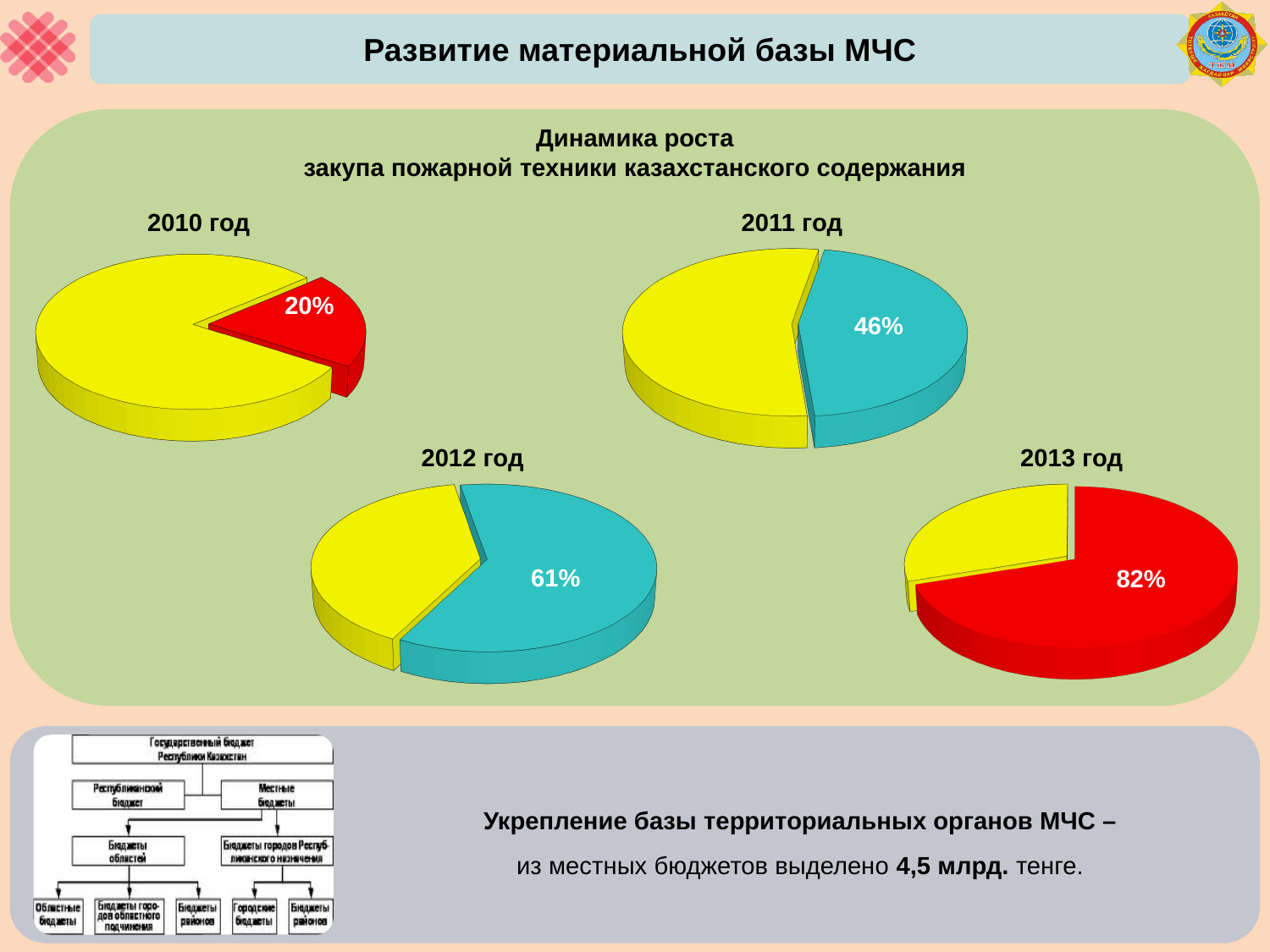
On the 2012 год pie chart, what percentage is shown on the labelled slice? 61% What is the difference between the labelled percentage on the 2013 год chart and the labelled percentage on the 2010 год chart? 62% What colour is the labelled 82% slice on the 2013 год pie chart? Red Which is larger: the labelled percentage on the 2012 год chart or on the 2011 год chart? 2012 год On the 2011 год pie chart, what percentage is shown on the labelled slice? 46% Which year's pie chart shows the lowest labelled percentage? 2010 год Which year's pie chart shows the highest labelled percentage? 2013 год How many pie charts are shown on the slide? 4 Do the labelled percentages rise or fall from 2010 год to 2013 год? Rise On the 2013 год pie chart, what percentage is shown on the labelled slice? 82% On the 2010 год pie chart, what percentage is shown on the labelled slice? 20% What type of chart is used for each year on the slide? Pie chart